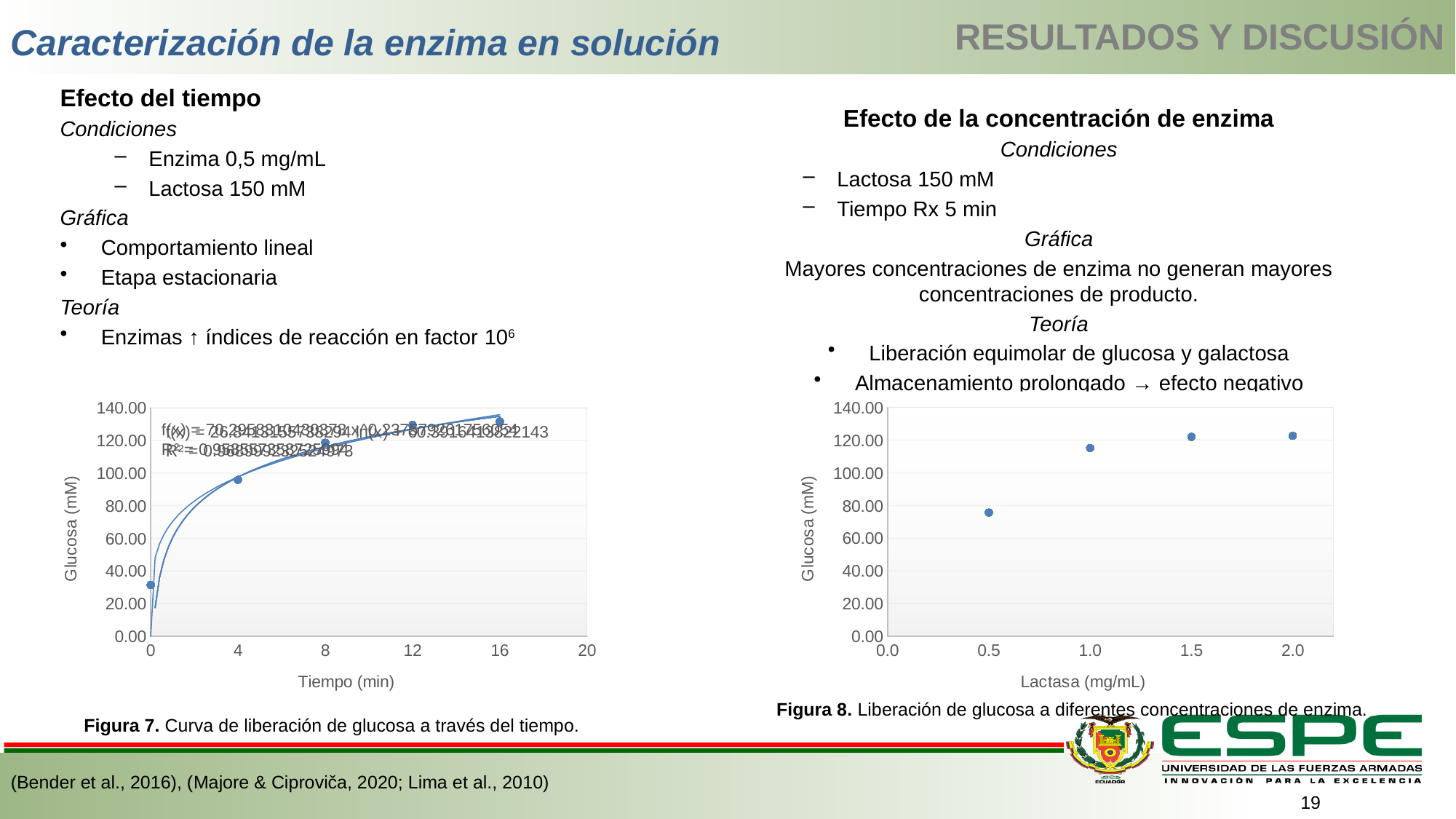
In Figura 7 (the left chart), is the glucose value at 0 min greater or less than 40? less In Figura 8 (the right chart, Lactasa vs Glucosa), how many data points are plotted? 4 What is the y-axis title of Figura 8 (the right chart)? Glucosa (mM) In Figura 7 (the left chart), is the glucose value at 4 min greater or less than 80? greater In Figura 8 (the right chart), is the glucose value at 0.5 mg/mL lactase greater or less than 60? greater What is the x-axis title of Figura 7 (the left chart)? Tiempo (min) In Figura 7 (the left chart), do the glucose values rise or fall as time increases? rise In Figura 7 (the left chart), at which time is the glucose value lowest? 0 min In Figura 7 (the left chart), how many data points are plotted? 5 In Figura 8 (the right chart), at which lactase concentration is the glucose value lowest? 0.5 mg/mL What kind of chart is Figura 7 (the left chart, Tiempo vs Glucosa)? scatter chart